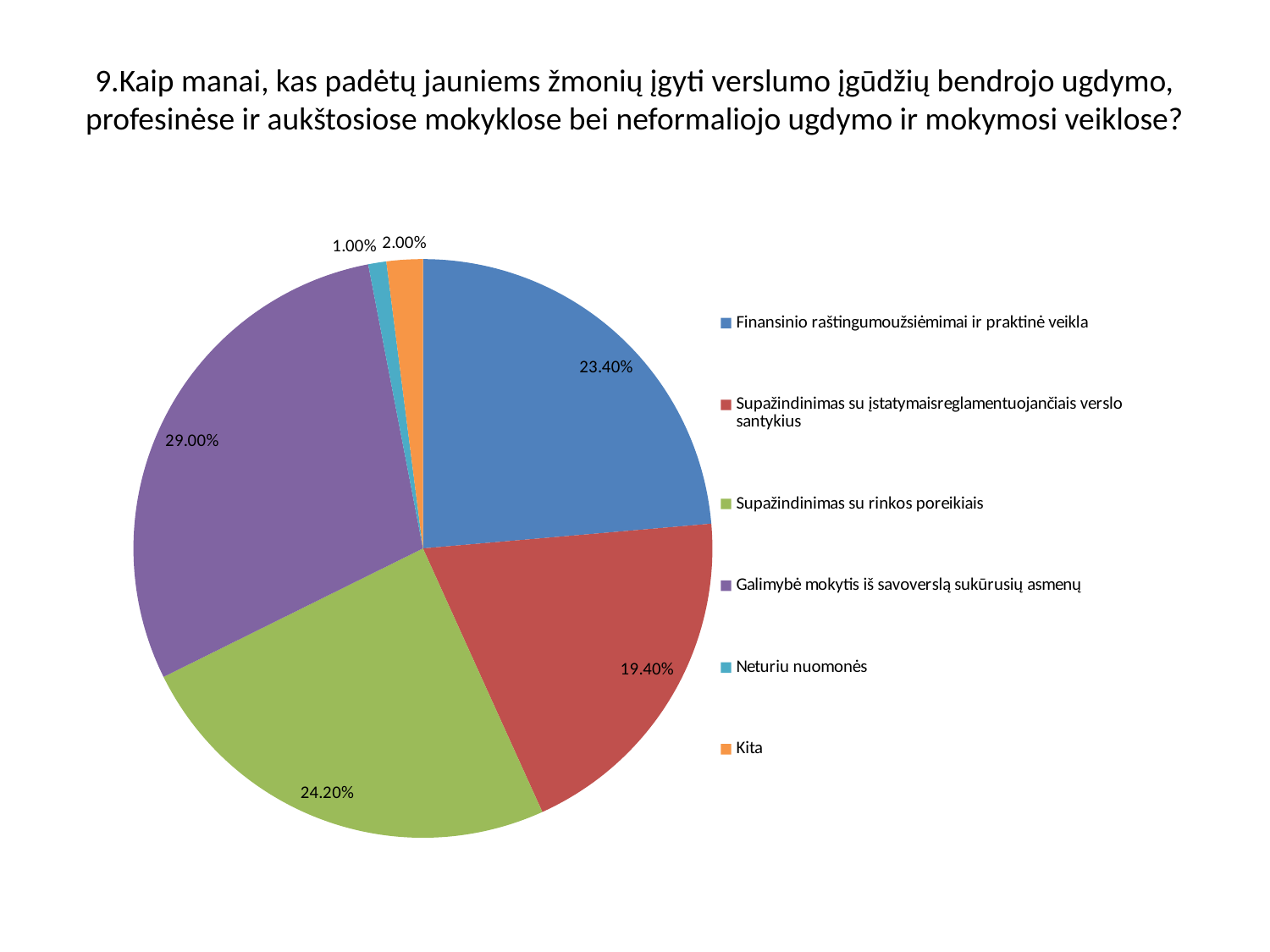
What percentage is shown for "Neturiu nuomonės"? 1.00% What percentage is shown for "Supažindinimas su įstatymais reglamentuojančiais verslo santykius"? 19.40% What type of chart is shown on the slide? pie chart What percentage is shown for "Finansinio raštingumo užsiėmimai ir praktinė veikla"? 23.40% What percentage is shown for "Supažindinimas su rinkos poreikiais"? 24.20% What is the difference in percentage points between "Galimybė mokytis iš savo verslą sukūrusių asmenų" and "Supažindinimas su įstatymais reglamentuojančiais verslo santykius"? 9.60% What percentage is shown for "Galimybė mokytis iš savo verslą sukūrusių asmenų"? 29.00% What percentage is shown for "Kita"? 2.00% Which is larger: the share for "Supažindinimas su rinkos poreikiais" or the share for "Finansinio raštingumo užsiėmimai ir praktinė veikla"? Supažindinimas su rinkos poreikiais Which category has the largest share of the pie? Galimybė mokytis iš savo verslą sukūrusių asmenų Which category has the smallest share of the pie? Neturiu nuomonės How many categories does the legend list? 6